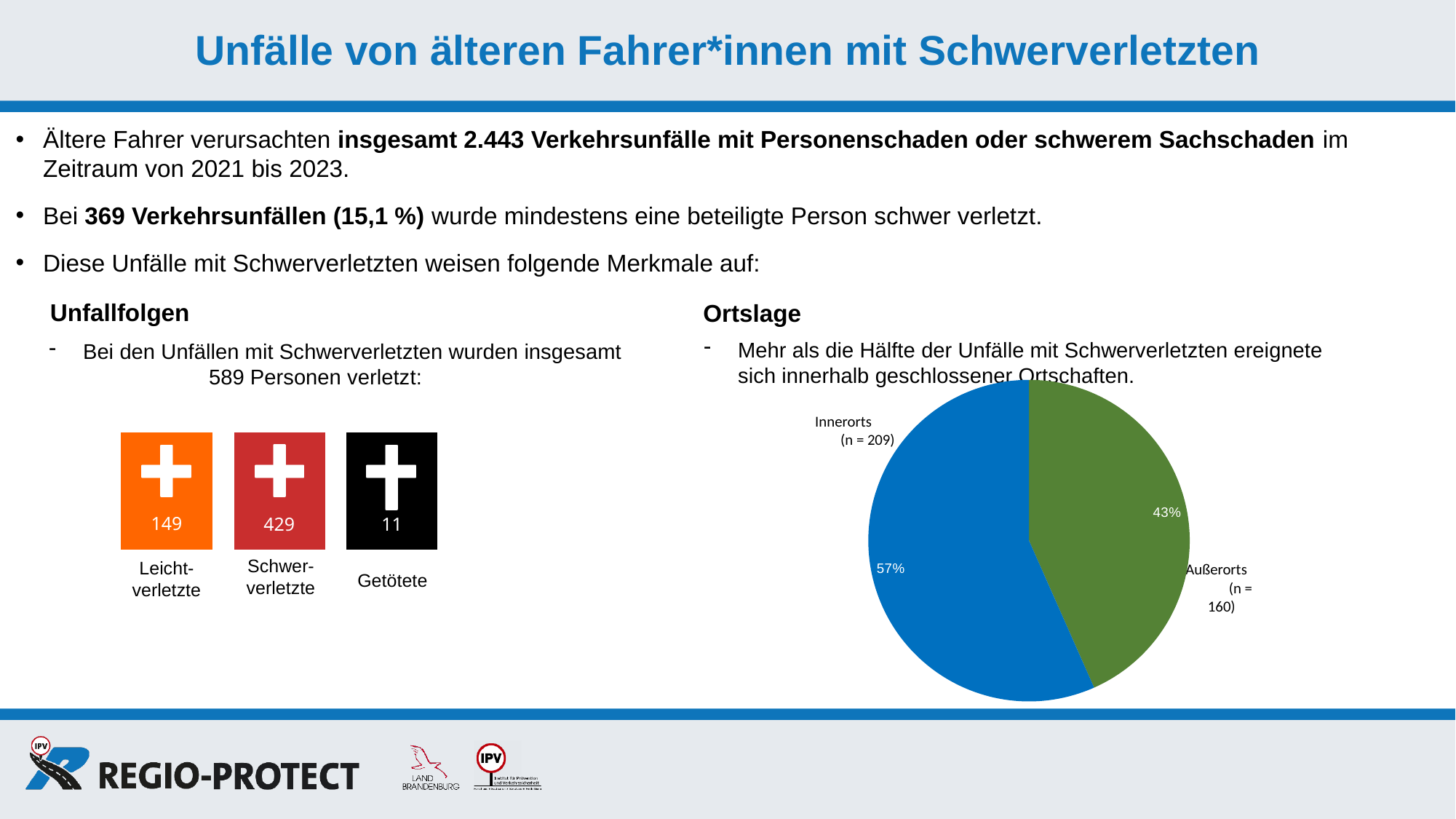
In the pie chart, what is the difference between the n values of Innerorts and Außerorts? 49 Which slice of the pie chart is the smallest? Außerorts What kind of chart is shown under the heading "Ortslage"? pie chart In the pie chart, what percentage share is shown for Innerorts? 57% What colour is the Innerorts slice in the pie chart? blue How many slices does the pie chart under "Ortslage" have? 2 In the pie chart, which is larger: Innerorts or Außerorts? Innerorts In the pie chart, what is the n value given for Innerorts? 209 In the pie chart, what is the n value given for Außerorts? 160 Which slice of the pie chart is the largest? Innerorts In the pie chart, by how many percentage points does the Innerorts share exceed the Außerorts share? 14 In the pie chart, what percentage share is shown for Außerorts? 43%